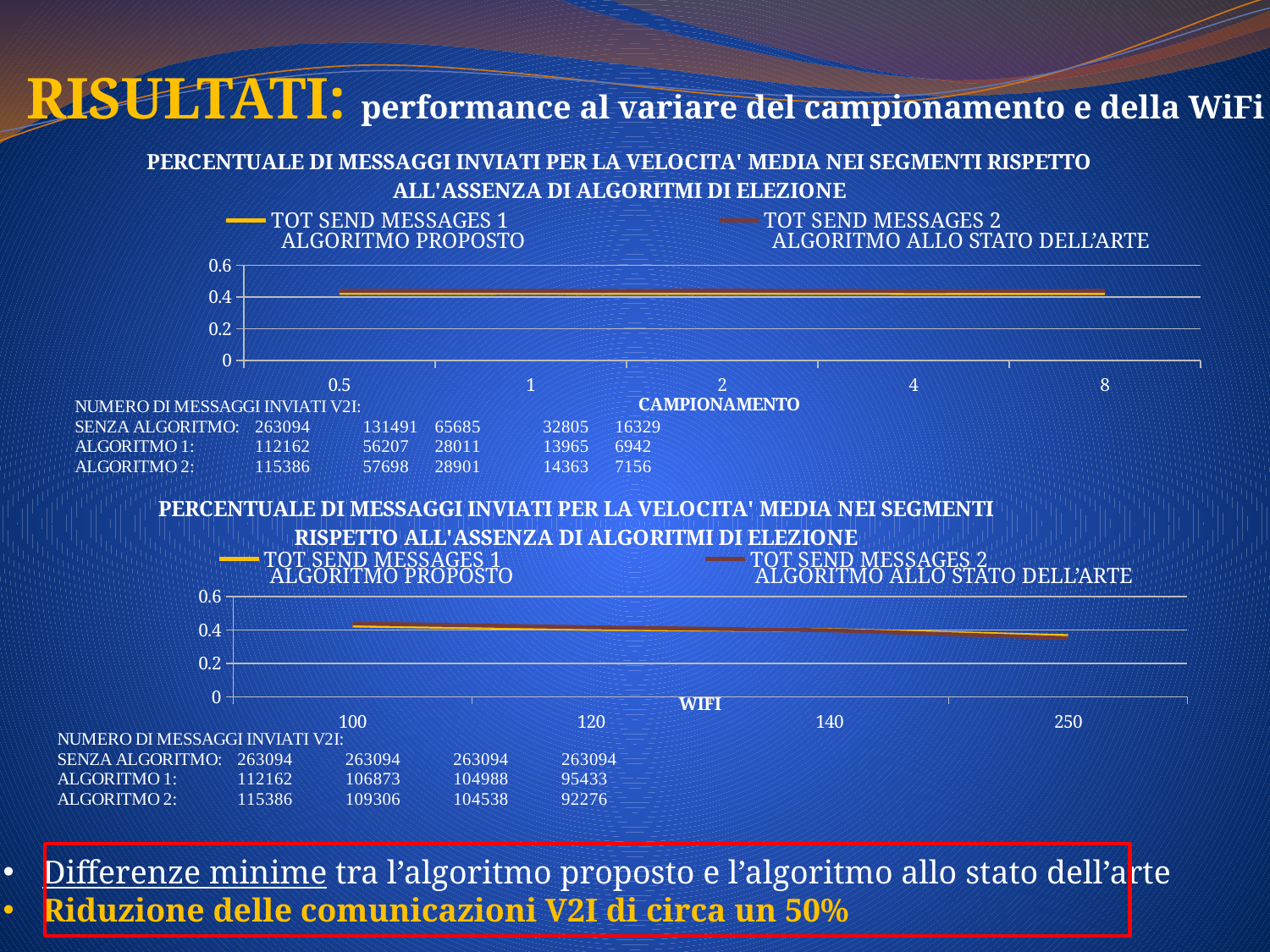
What kind of chart is the bottom chart (WIFI)? line chart In the bottom chart, is the value of TOT SEND MESSAGES 2 at WiFi 100 greater or less than 0.2? greater In the top chart, is the value of TOT SEND MESSAGES 1 at campionamento 0.5 greater or less than 0.2? greater In the bottom chart, how many categories are shown on the WIFI axis? 4 In the bottom chart, is the value of TOT SEND MESSAGES 1 at WiFi 250 greater or less than 0.6? less In the top chart, how many categories are shown on the CAMPIONAMENTO axis? 5 What kind of chart is the top chart (CAMPIONAMENTO)? line chart How many series does the legend of the bottom chart list? 2 How many series does the legend of the top chart list? 2 In the top chart, which series is labelled ALGORITMO PROPOSTO in the legend? TOT SEND MESSAGES 1 In the bottom chart, do the values rise or fall as WiFi increases from 100 to 250? fall